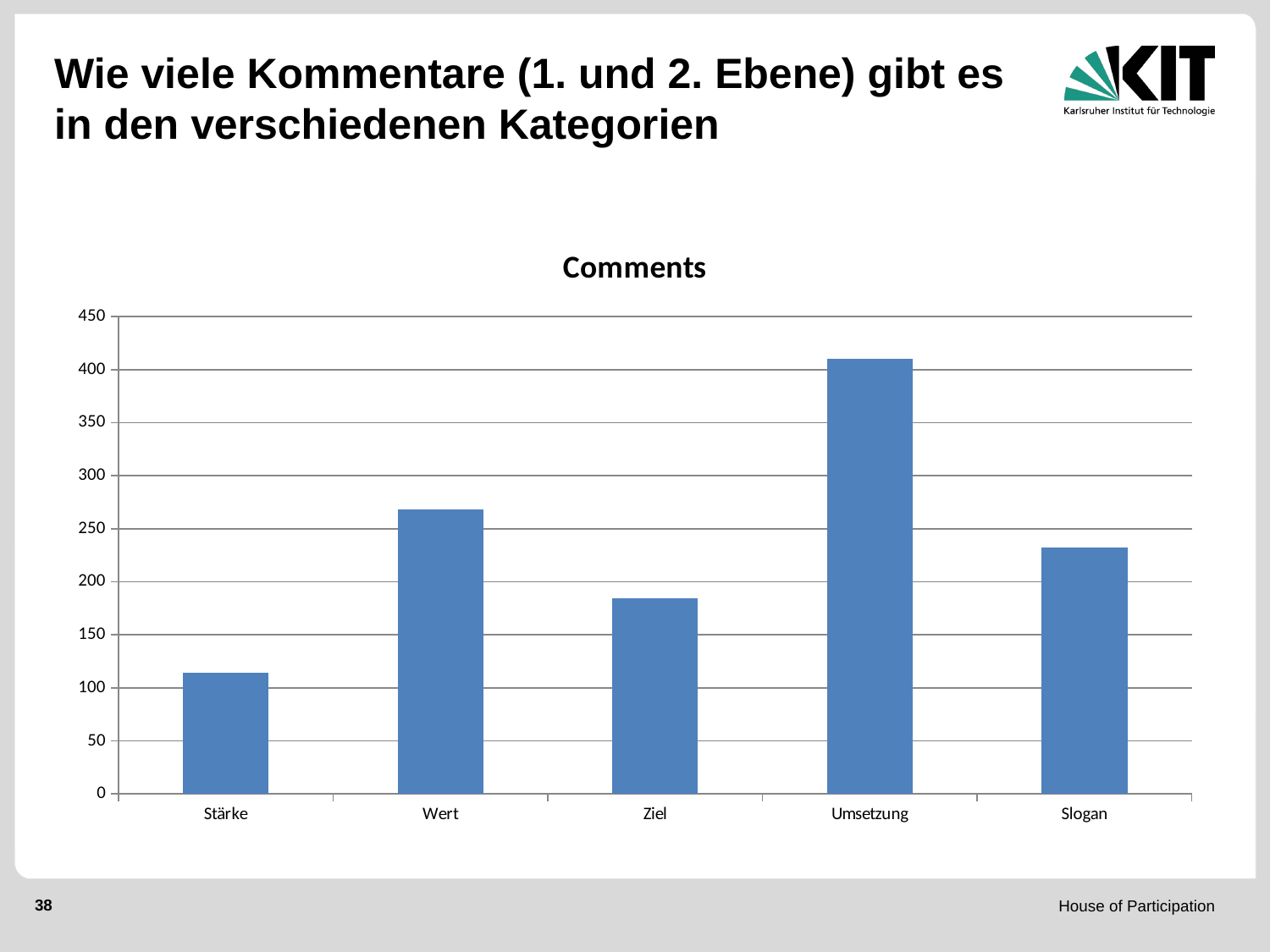
Is the value for Wert greater or less than 250? greater Which category has the highest number of comments? Umsetzung Is the value for Umsetzung greater or less than 350? greater What is the title of the chart? Comments Is the value for Ziel greater or less than 200? less How many categories are shown on the x axis of the chart? 5 Which category has the lowest number of comments? Stärke Which has more comments, Wert or Slogan? Wert What type of chart is shown on the slide? bar chart